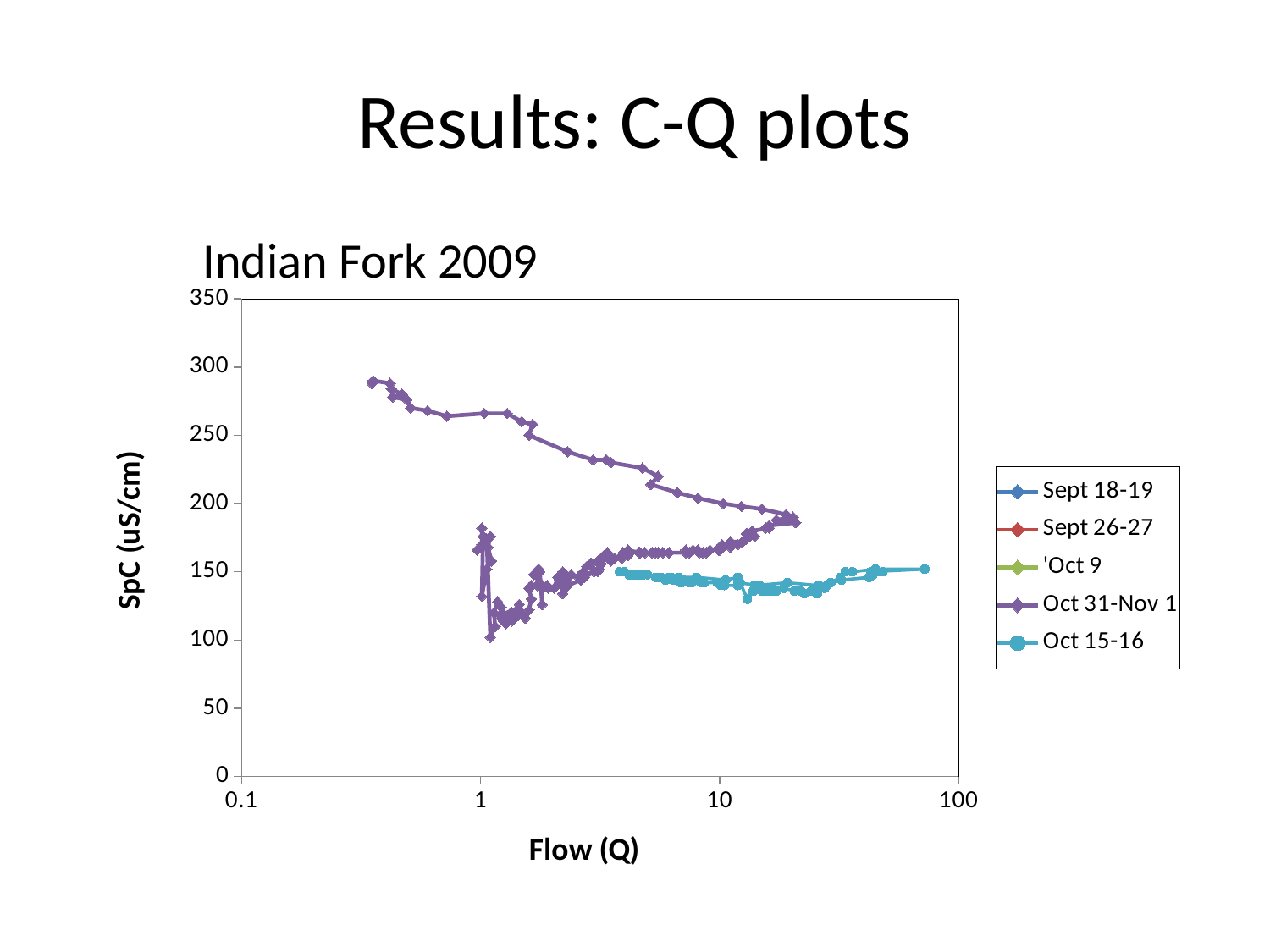
What kind of chart is shown on the slide? scatter plot with connected markers How many series does the chart's legend list? 5 How many of the legend's series have visible data plotted on the chart? 2 What is the title of the chart on the slide? Indian Fork 2009 Is the lowest SpC value of the Oct 31-Nov 1 series greater or less than 150? less Is the highest SpC value of the Oct 31-Nov 1 series greater or less than 250? greater Along the upper branch of the Oct 31-Nov 1 series, does SpC rise or fall as flow increases? fall Which series reaches the highest SpC values on the chart? Oct 31-Nov 1 Are the SpC values of the Oct 15-16 series greater or less than 100? greater What is the label of the y-axis? SpC (uS/cm) Which series extends to the highest flow values on the chart? Oct 15-16